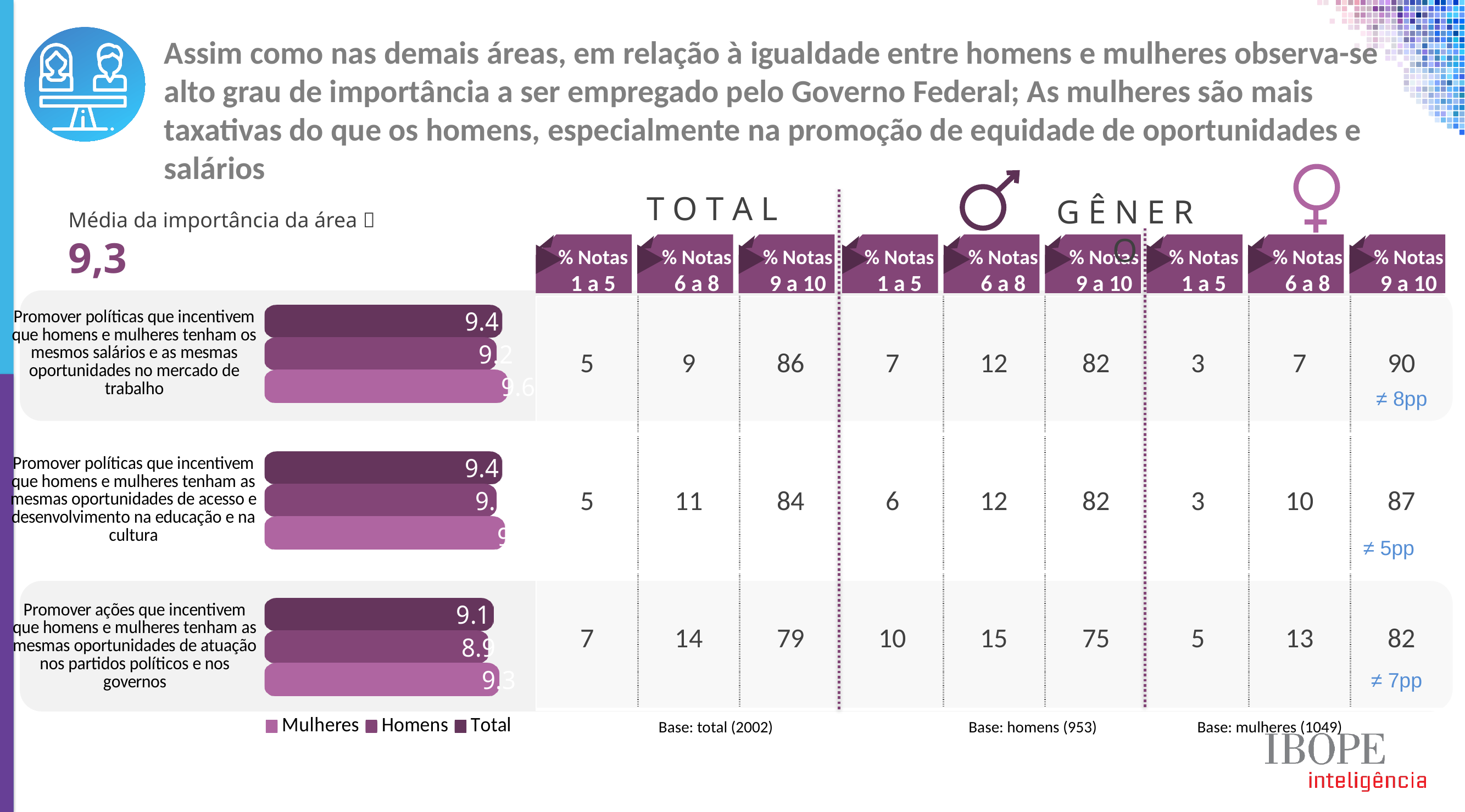
Which category has the lowest Total value? Promover ações que incentivem que homens e mulheres tenham as mesmas oportunidades de atuação nos partidos políticos e nos governos How many categories (policy statements) are plotted in the bar chart? 3 What is the Total value for 'Promover políticas que incentivem que homens e mulheres tenham os mesmos salários e as mesmas oportunidades no mercado de trabalho'? 9.4 What is the Total value for 'Promover políticas que incentivem que homens e mulheres tenham as mesmas oportunidades de acesso e desenvolvimento na educação e na cultura'? 9.4 For the category about opportunities in political parties and governments, which is larger: the Mulheres value or the Homens value? Mulheres How many series does the chart legend list? 3 What kind of chart is shown on the slide? bar chart What is the Mulheres value for 'Promover políticas que incentivem que homens e mulheres tenham os mesmos salários e as mesmas oportunidades no mercado de trabalho'? 9.6 What is the Total value for 'Promover ações que incentivem que homens e mulheres tenham as mesmas oportunidades de atuação nos partidos políticos e nos governos'? 9.1 What is the Mulheres value for 'Promover ações que incentivem que homens e mulheres tenham as mesmas oportunidades de atuação nos partidos políticos e nos governos'? 9.3 For the category about opportunities in political parties and governments, what is the difference between the Mulheres value and the Homens value? 0.4 What is the Homens value for 'Promover ações que incentivem que homens e mulheres tenham as mesmas oportunidades de atuação nos partidos políticos e nos governos'? 8.9